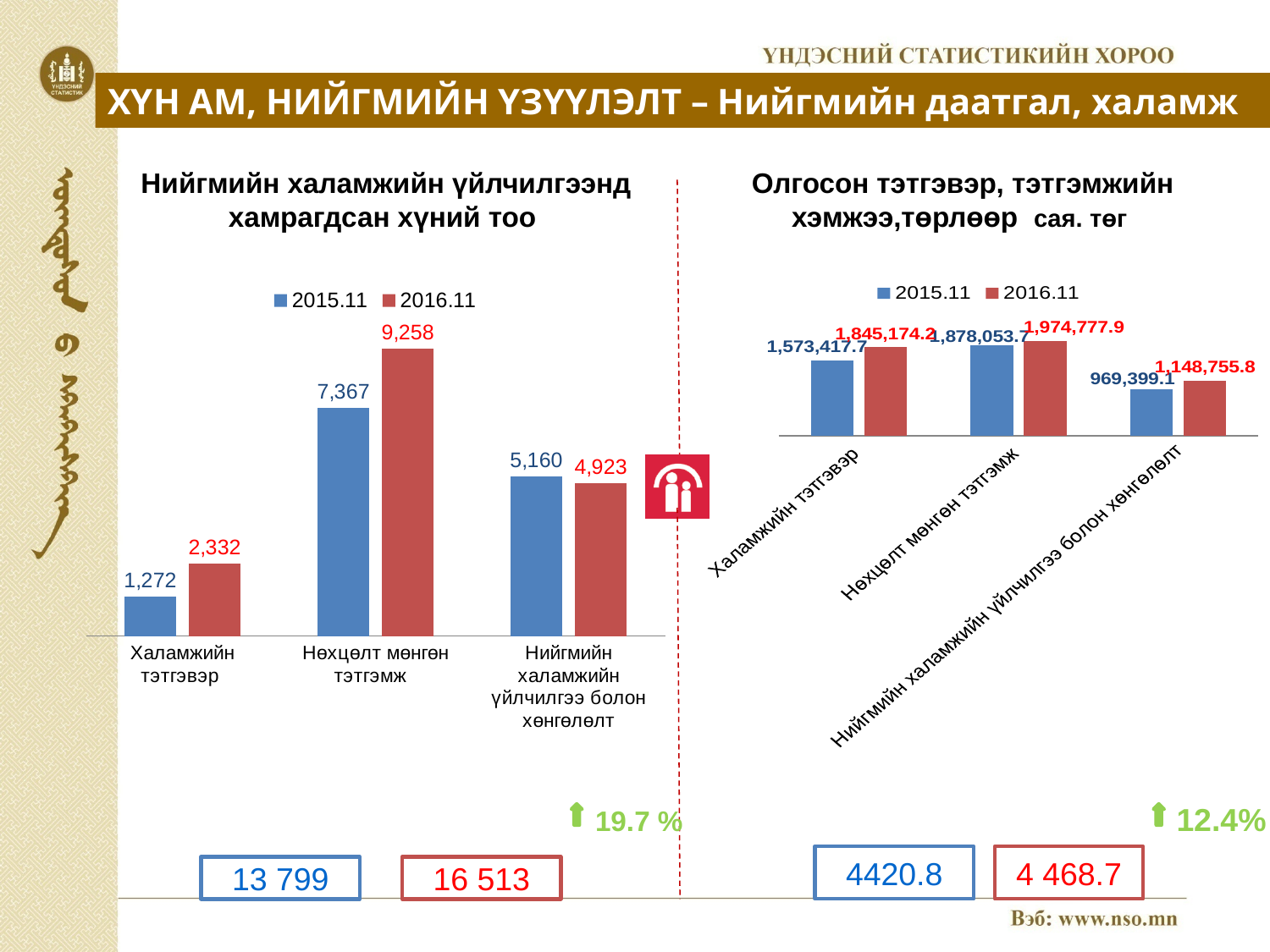
In the right chart (Олгосон тэтгэвэр, тэтгэмжийн хэмжээ, төрлөөр), what is the 2016.11 value for Нөхцөлт мөнгөн тэтгэмж? 1,974,777.9 In the left chart (Нийгмийн халамжийн үйлчилгээнд хамрагдсан хүний тоо), which category has the highest 2016.11 value? Нөхцөлт мөнгөн тэтгэмж What kind of chart is the right chart (Олгосон тэтгэвэр, тэтгэмжийн хэмжээ, төрлөөр)? Bar chart How many categories are shown on the x axis of the right chart (Олгосон тэтгэвэр, тэтгэмжийн хэмжээ, төрлөөр)? 3 In the left chart (Нийгмийн халамжийн үйлчилгээнд хамрагдсан хүний тоо), what is the 2016.11 value for Нөхцөлт мөнгөн тэтгэмж? 9,258 In the left chart (Нийгмийн халамжийн үйлчилгээнд хамрагдсан хүний тоо), what is the 2015.11 value for Халамжийн тэтгэвэр? 1,272 In the right chart (Олгосон тэтгэвэр, тэтгэмжийн хэмжээ, төрлөөр), which category has the lowest 2016.11 value? Нийгмийн халамжийн үйлчилгээ болон хөнгөлөлт How many series does the legend of the left chart (Нийгмийн халамжийн үйлчилгээнд хамрагдсан хүний тоо) list? 2 In the left chart (Нийгмийн халамжийн үйлчилгээнд хамрагдсан хүний тоо), what is the difference between the 2016.11 and 2015.11 values for Халамжийн тэтгэвэр? 1,060 In the left chart (Нийгмийн халамжийн үйлчилгээнд хамрагдсан хүний тоо), for Нийгмийн халамжийн үйлчилгээ болон хөнгөлөлт, which is larger: the 2015.11 value or the 2016.11 value? 2015.11 In the left chart (Нийгмийн халамжийн үйлчилгээнд хамрагдсан хүний тоо), which category has the lowest 2015.11 value? Халамжийн тэтгэвэр In the right chart (Олгосон тэтгэвэр, тэтгэмжийн хэмжээ, төрлөөр), what is the 2015.11 value for Нийгмийн халамжийн үйлчилгээ болон хөнгөлөлт? 969,399.1